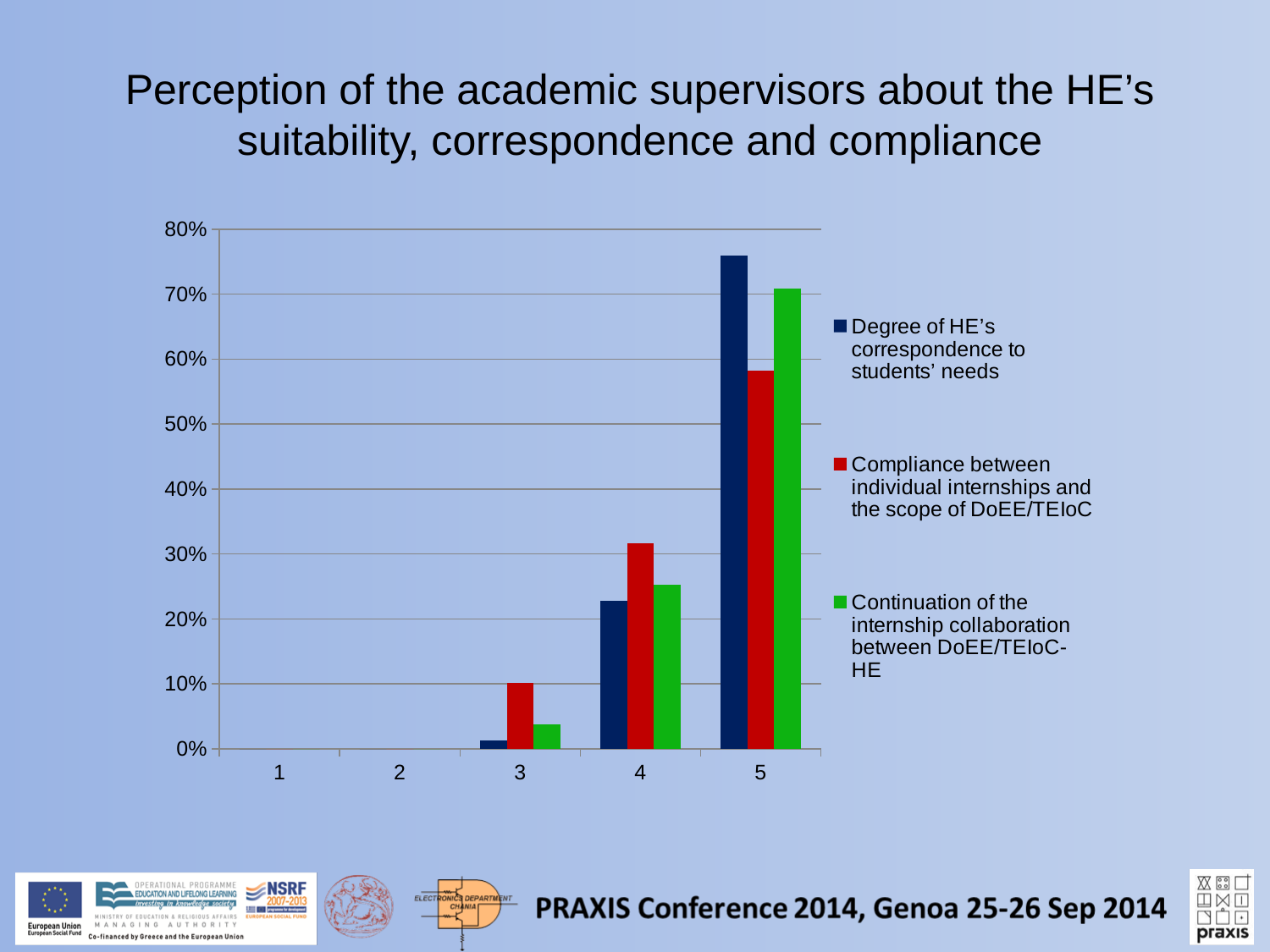
At category 5, which is larger: 'Degree of HE's correspondence to students' needs' or 'Compliance between individual internships and the scope of DoEE/TEIoC'? Degree of HE's correspondence to students' needs Is the value for 'Degree of HE's correspondence to students' needs' at category 4 greater or less than 30%? less What kind of chart is shown on the slide? bar chart What colour represents 'Continuation of the internship collaboration between DoEE/TEIoC-HE' in the legend? green Is the value for 'Compliance between individual internships and the scope of DoEE/TEIoC' at category 5 greater or less than 50%? greater Do the values for 'Continuation of the internship collaboration between DoEE/TEIoC-HE' rise or fall from category 3 to category 5? rise Is the value for 'Degree of HE's correspondence to students' needs' at category 5 greater or less than 70%? greater At category 4, which is larger: 'Degree of HE's correspondence to students' needs' or 'Compliance between individual internships and the scope of DoEE/TEIoC'? Compliance between individual internships and the scope of DoEE/TEIoC For which category is the bar for 'Degree of HE's correspondence to students' needs' the tallest? 5 How many series does the legend list? 3 How many categories are shown on the x axis? 5 For which category is the bar for 'Compliance between individual internships and the scope of DoEE/TEIoC' the tallest? 5